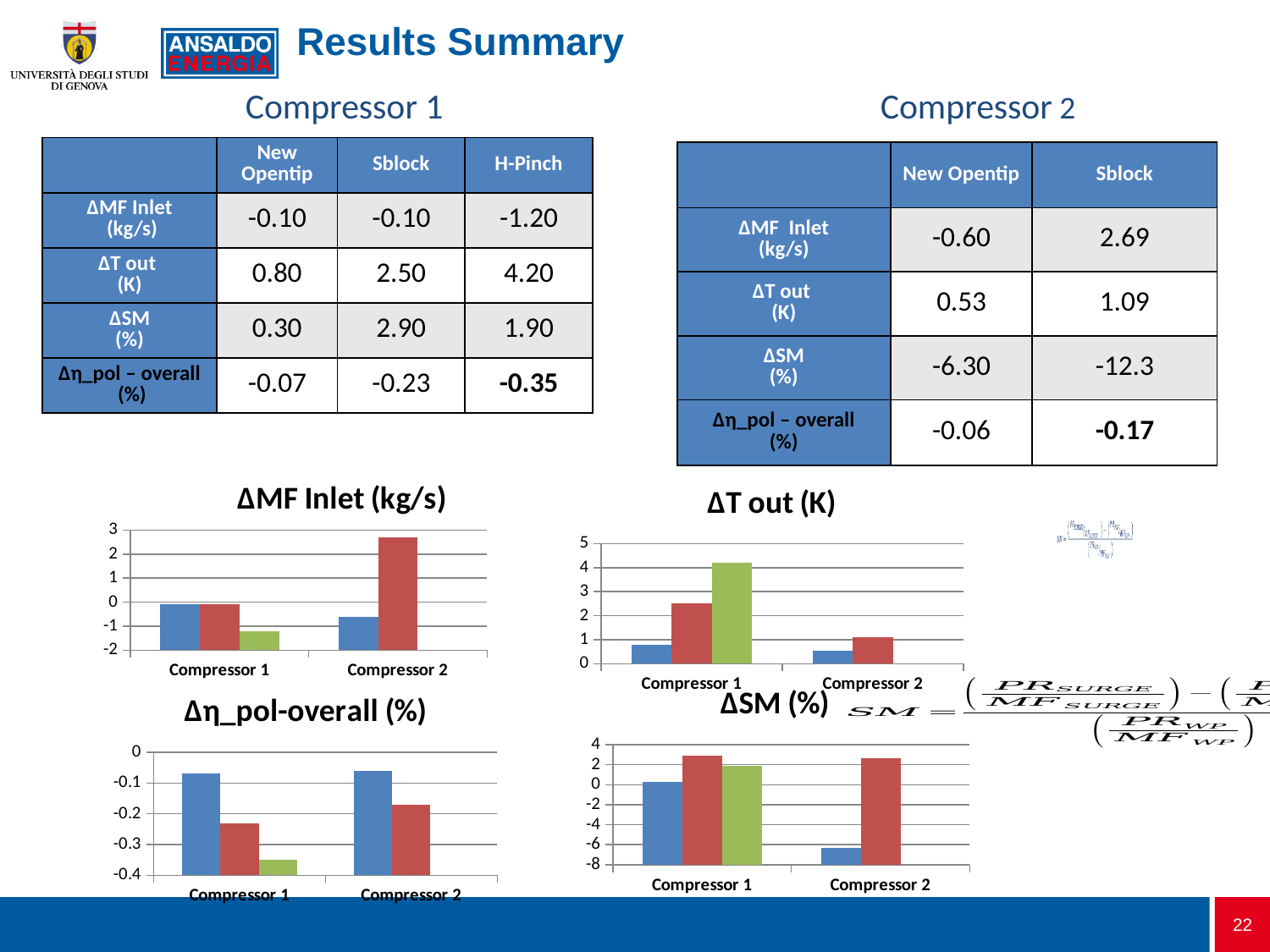
In the ΔT out (K) chart, is the value of the green bar for Compressor 1 greater or less than 3? greater What kind of chart is the ΔMF Inlet (kg/s) chart? bar chart In the ΔMF Inlet (kg/s) chart, which category contains the lowest bar? Compressor 1 In the ΔMF Inlet (kg/s) chart, is the value of the red bar for Compressor 2 greater or less than 2? greater In the ΔT out (K) chart, what is the value of the H-Pinch (green) bar for Compressor 1, as given in the Compressor 1 table? 4.20 In the ΔSM (%) chart, is the value of the blue bar for Compressor 2 greater or less than -4? less What is the title of the chart in the bottom-left corner of the slide? Δη_pol-overall (%) In the Δη_pol-overall (%) chart, which is lower: the green bar for Compressor 1 or the red bar for Compressor 2? the green bar for Compressor 1 In the ΔT out (K) chart, how many categories are shown on the x axis? 2 In the ΔMF Inlet (kg/s) chart, do the blue bars rise or fall from Compressor 1 to Compressor 2? fall In the ΔT out (K) chart, which category contains the tallest bar? Compressor 1